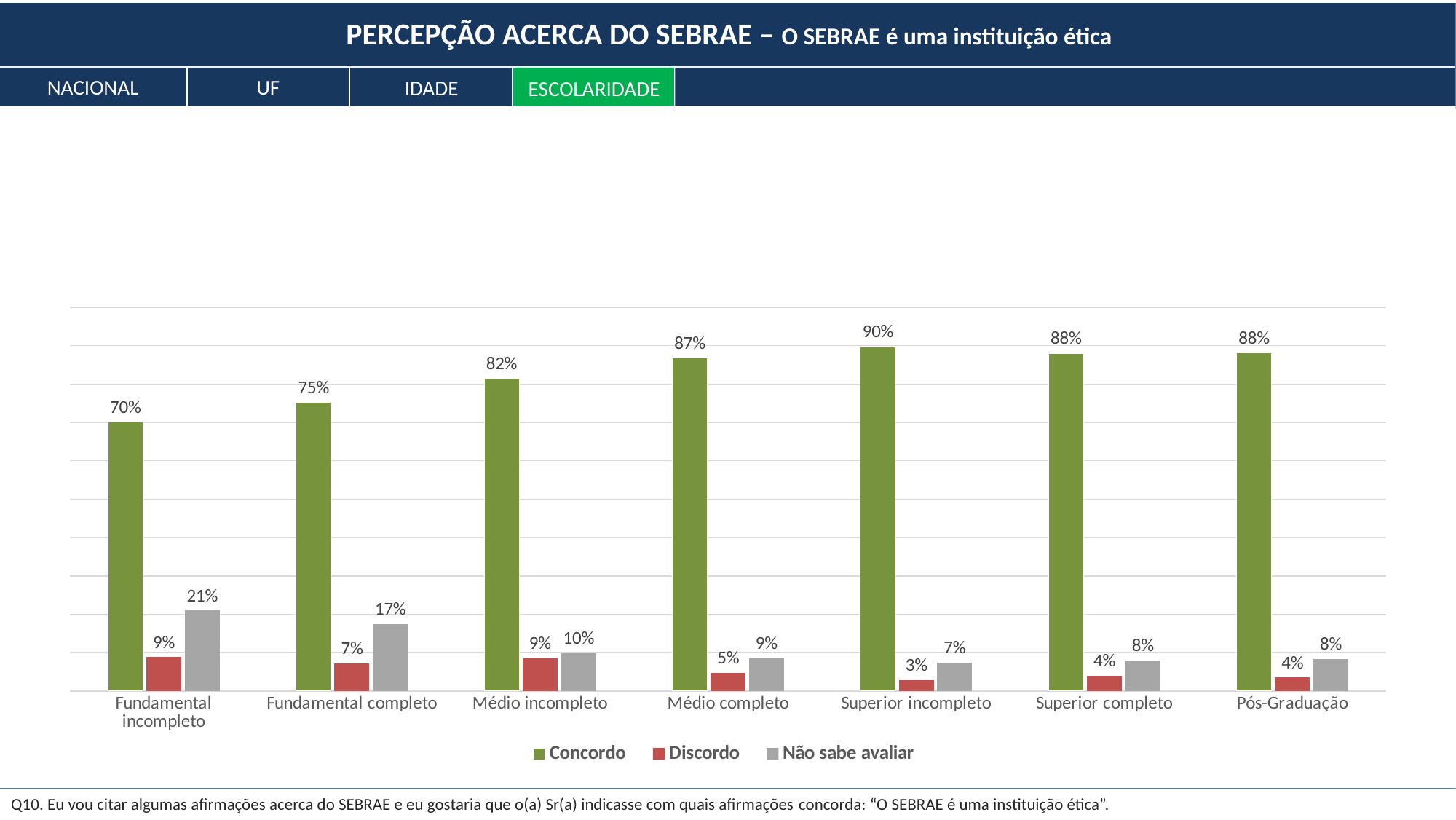
How many series does the legend list? 3 What is the difference between the Concordo values for Pós-Graduação and Fundamental incompleto? 18% Which category has the lowest Discordo value? Superior incompleto What is the Discordo value for Médio completo? 5% How many education categories are shown on the x axis? 7 Which category has the lowest Concordo value? Fundamental incompleto What is the Não sabe avaliar value for Fundamental incompleto? 21% Which is larger, the Não sabe avaliar value for Fundamental completo or for Médio incompleto? Fundamental completo What kind of chart is shown on the slide? Bar chart Which category has the highest Concordo value? Superior incompleto What is the Concordo value for Superior incompleto? 90% Which tab is highlighted in green at the top of the slide? ESCOLARIDADE